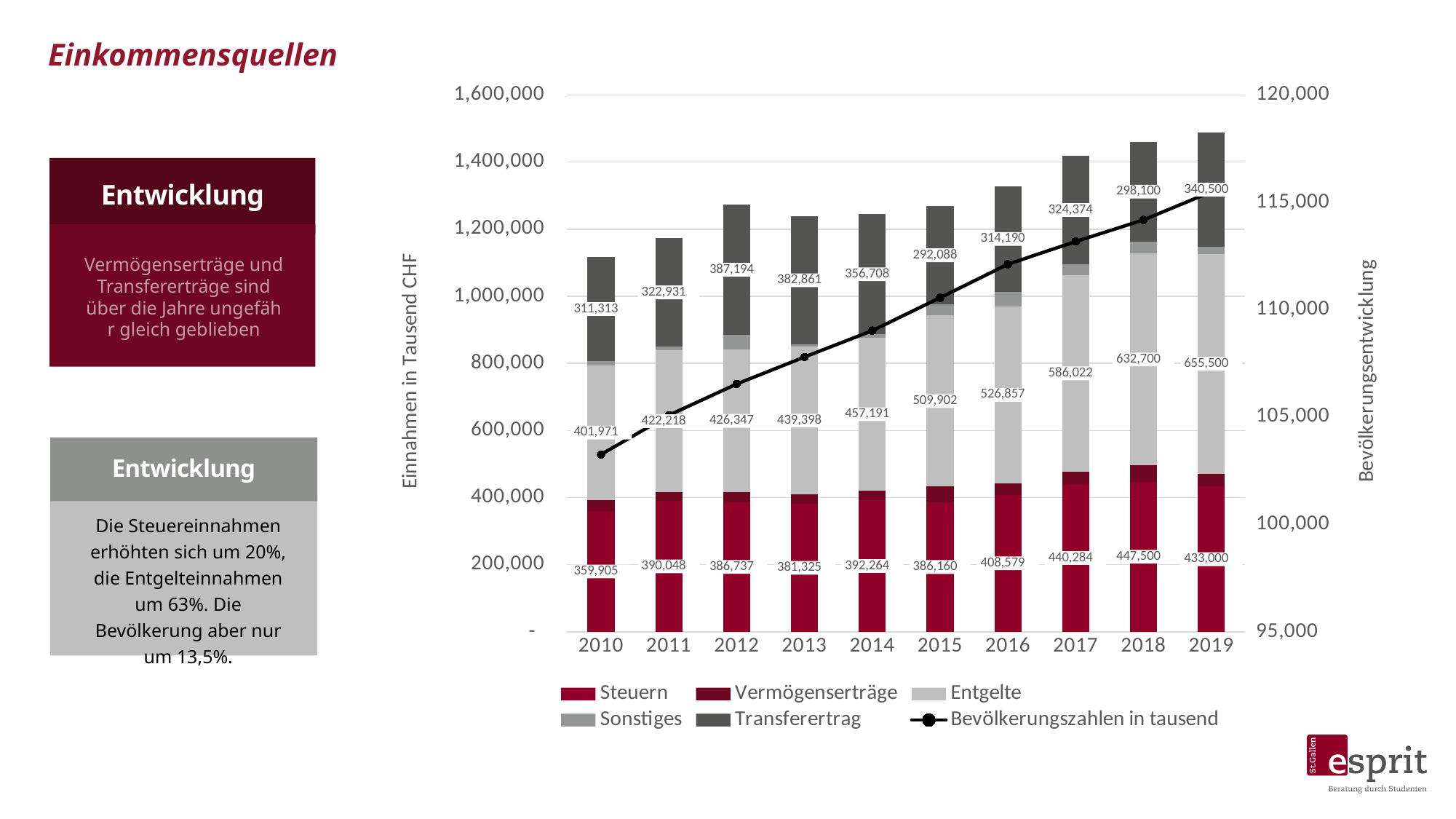
What is the value of Steuern for 2010? 359,905 Which is larger, Transferertrag in 2015 or Transferertrag in 2016? 2016 What is the difference between Entgelte in 2019 and Entgelte in 2010? 253,529 Is the total height of the stacked bar for 2019 greater or less than 1,400,000? greater In which year is Entgelte highest? 2019 What is the difference between Steuern in 2018 and Steuern in 2019? 14,500 What is the value of Entgelte for 2019? 655,500 What is the value of Transferertrag for 2012? 387,194 How many years are shown on the x axis? 10 Does the Bevölkerungszahlen in tausend line rise or fall from 2010 to 2019? rise How many series does the legend list? 6 In which year is Steuern lowest? 2010